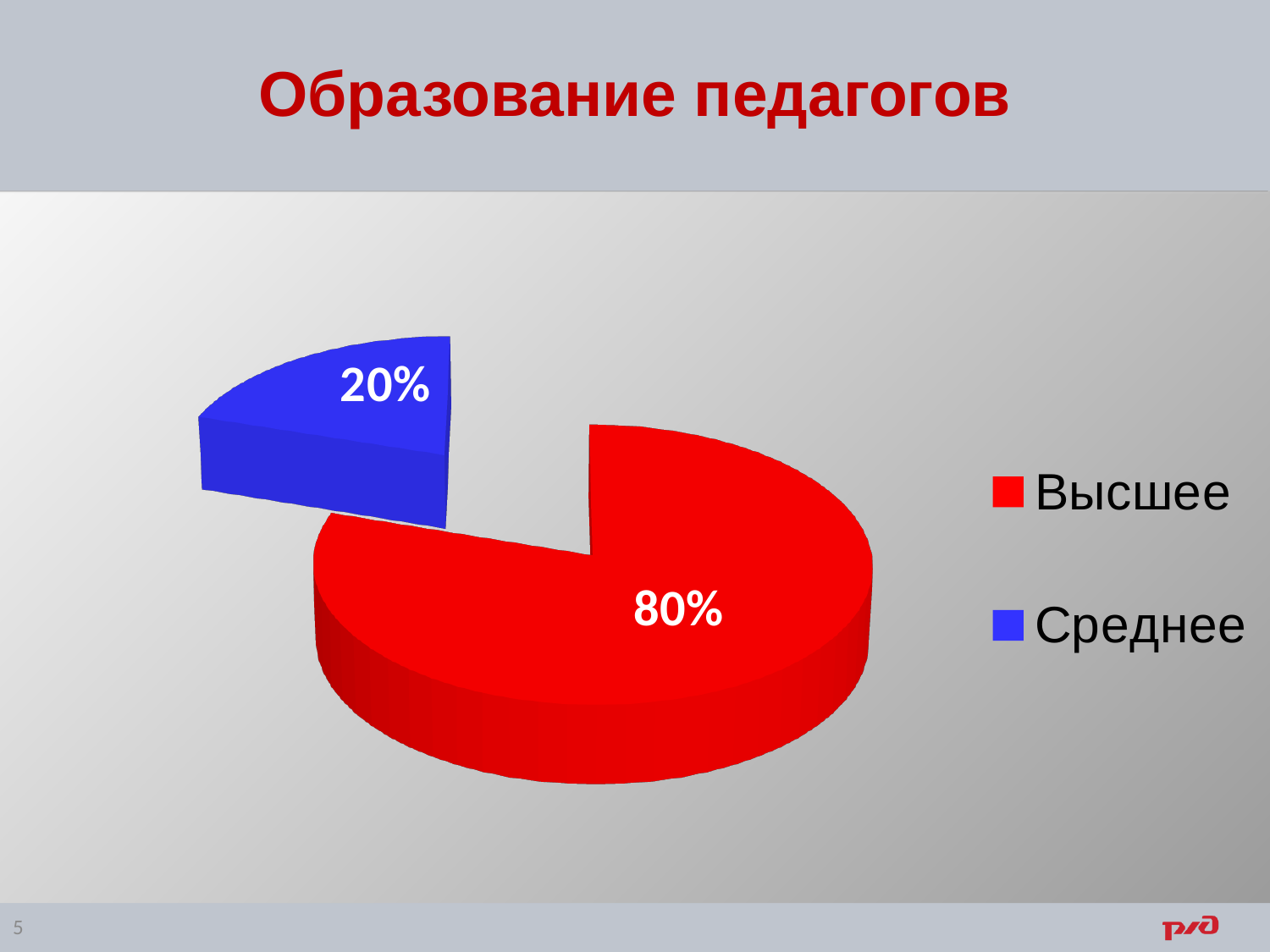
What share of the pie does Высшее have? 80% What is the difference in percentage points between Высшее and Среднее? 60 What is the title of the slide? Образование педагогов What kind of chart is shown on the slide? Pie chart Which category has the smallest slice of the pie? Среднее Which is larger, the slice for Высшее or the slice for Среднее? Высшее What colour is the slice for Среднее? Blue What share of the pie does Среднее have? 20% How many slices does the pie chart have? 2 Which category has the largest slice of the pie? Высшее